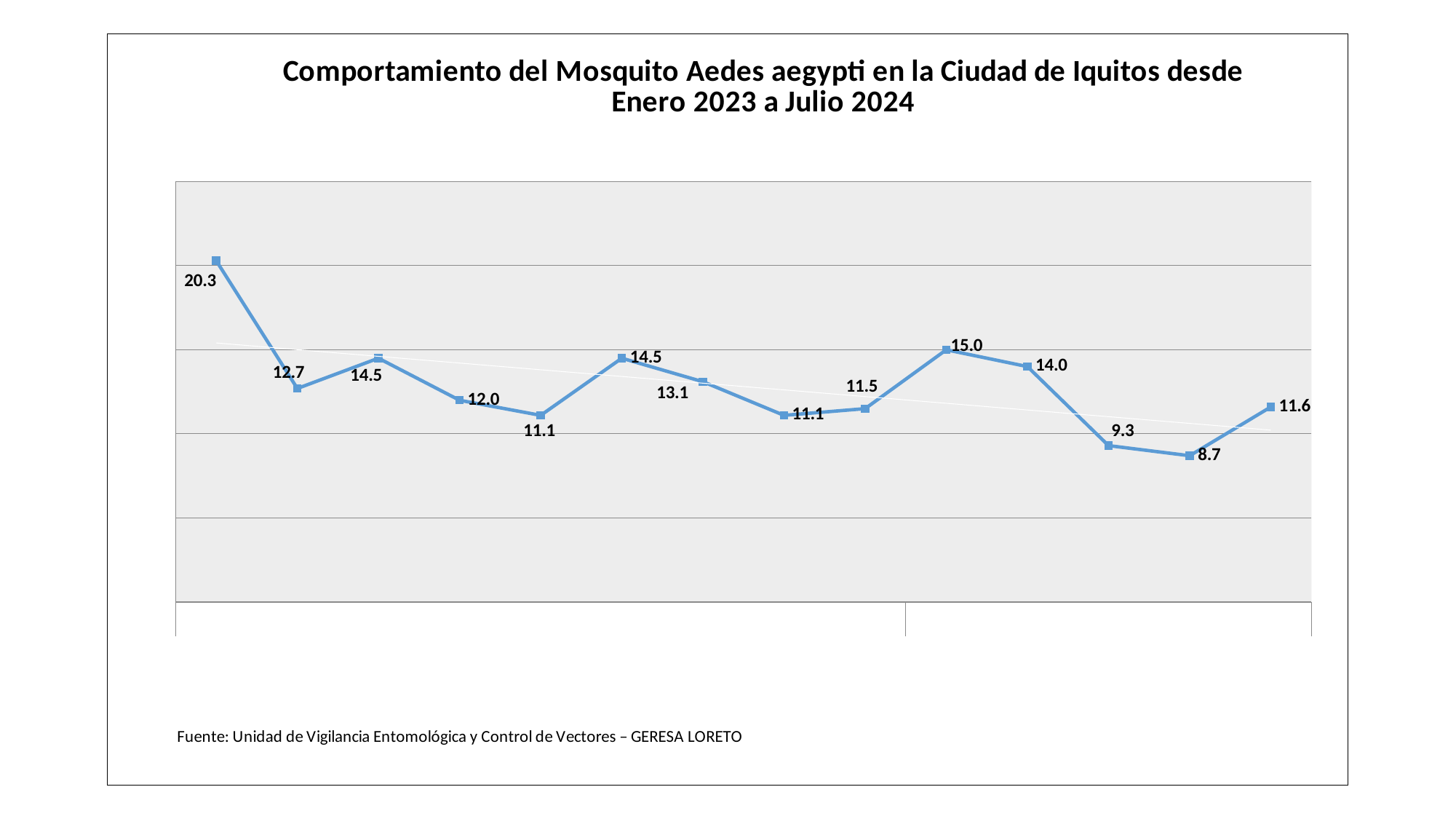
What is the lowest value plotted on the chart? 8.7 How many data points are plotted on the line? 14 What source is cited below the chart? Unidad de Vigilancia Entomológica y Control de Vectores – GERESA LORETO What is the value of the last data point on the line? 11.6 What is the highest value plotted on the chart? 20.3 Do the values generally rise or fall from left to right along the x axis? fall What kind of chart is shown on the slide? line chart What is the difference between the first data point (20.3) and the last data point (11.6)? 8.7 What is the difference between the highest value (20.3) and the lowest value (8.7) on the chart? 11.6 What is the title of the chart? Comportamiento del Mosquito Aedes aegypti en la Ciudad de Iquitos desde Enero 2023 a Julio 2024 Which is larger, the first data point or the last data point on the line? the first data point What is the value of the first data point on the line? 20.3